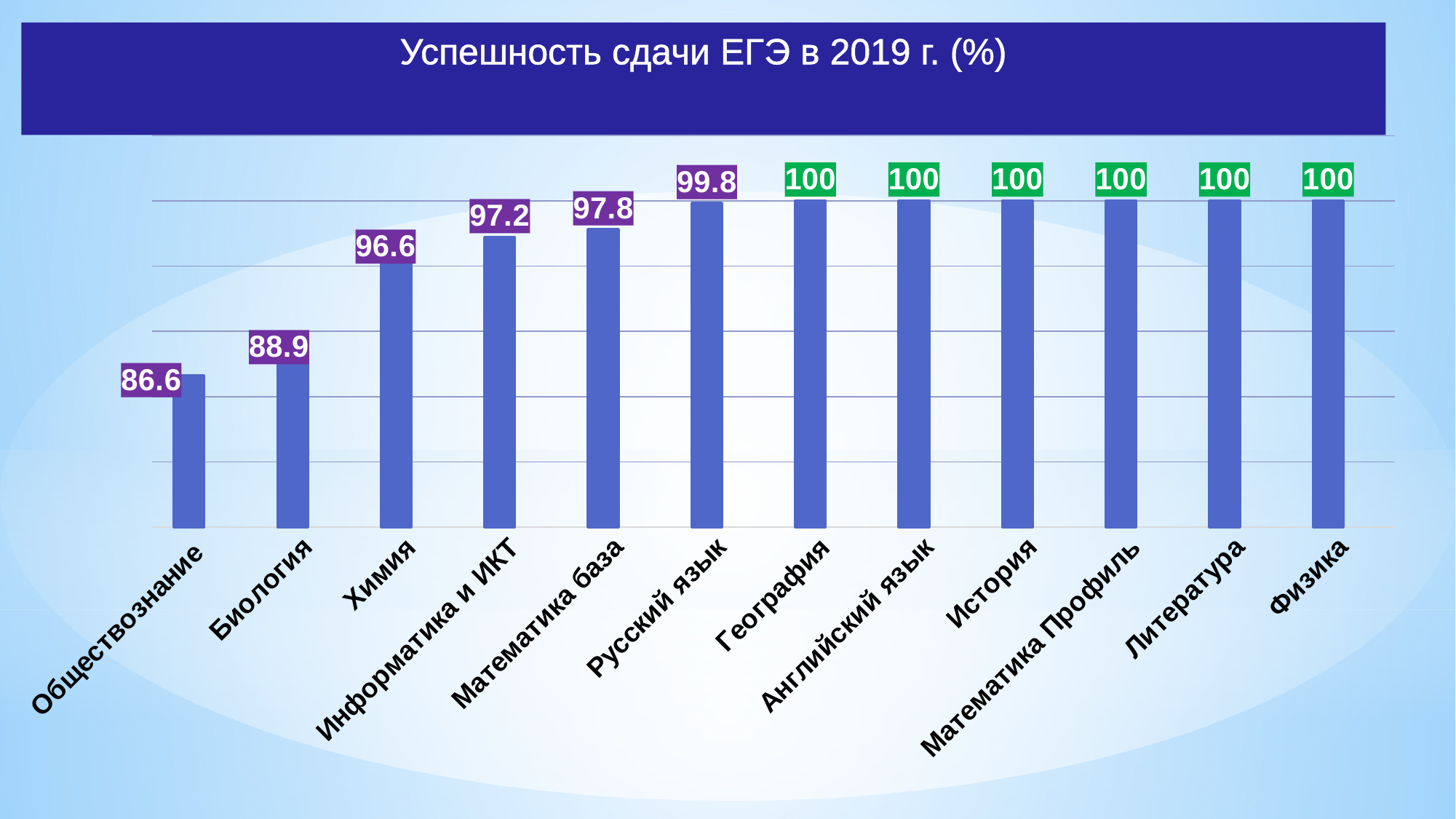
What kind of chart is shown on the slide? Bar chart What is the value for Обществознание? 86.6 What is the value for Русский язык? 99.8 What is the title of the chart? Успешность сдачи ЕГЭ в 2019 г. (%) What is the value for Математика база? 97.8 How many categories are shown on the chart? 12 Which is larger, the value for Химия or the value for Биология? Химия What is the value for Биология? 88.9 Which category has the lowest value? Обществознание What is the value for Химия? 96.6 What is the difference between the values for Математика база and Информатика и ИКТ? 0.6 What is the difference between the values for Биология and Обществознание? 2.3